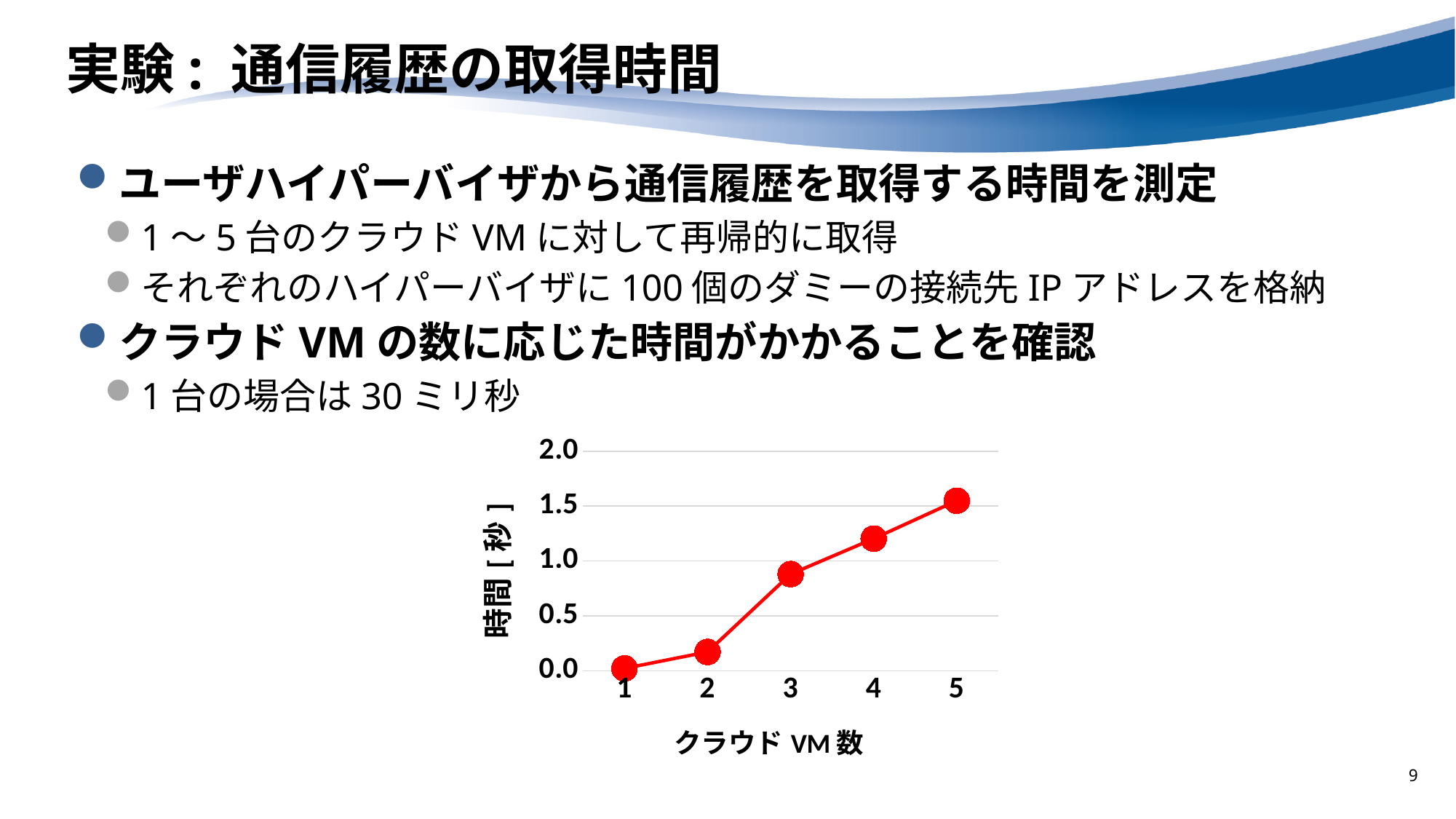
Which number of cloud VMs (クラウド VM 数) has the lowest time? 1 What is the label of the y axis of the chart? 時間 [秒] Is the time for 5 cloud VMs greater or less than 2.0 seconds? less What kind of chart is shown on the slide? line chart Is the time for 2 cloud VMs greater or less than 0.5 seconds? less Is the time for 3 cloud VMs greater or less than 0.5 seconds? greater Which number of cloud VMs (クラウド VM 数) has the highest time? 5 Which has a larger time: 4 cloud VMs or 2 cloud VMs? 4 cloud VMs How many data points are plotted on the chart? 5 Do the values rise or fall as the number of cloud VMs increases from 1 to 5? rise What is the label of the x axis of the chart? クラウド VM 数